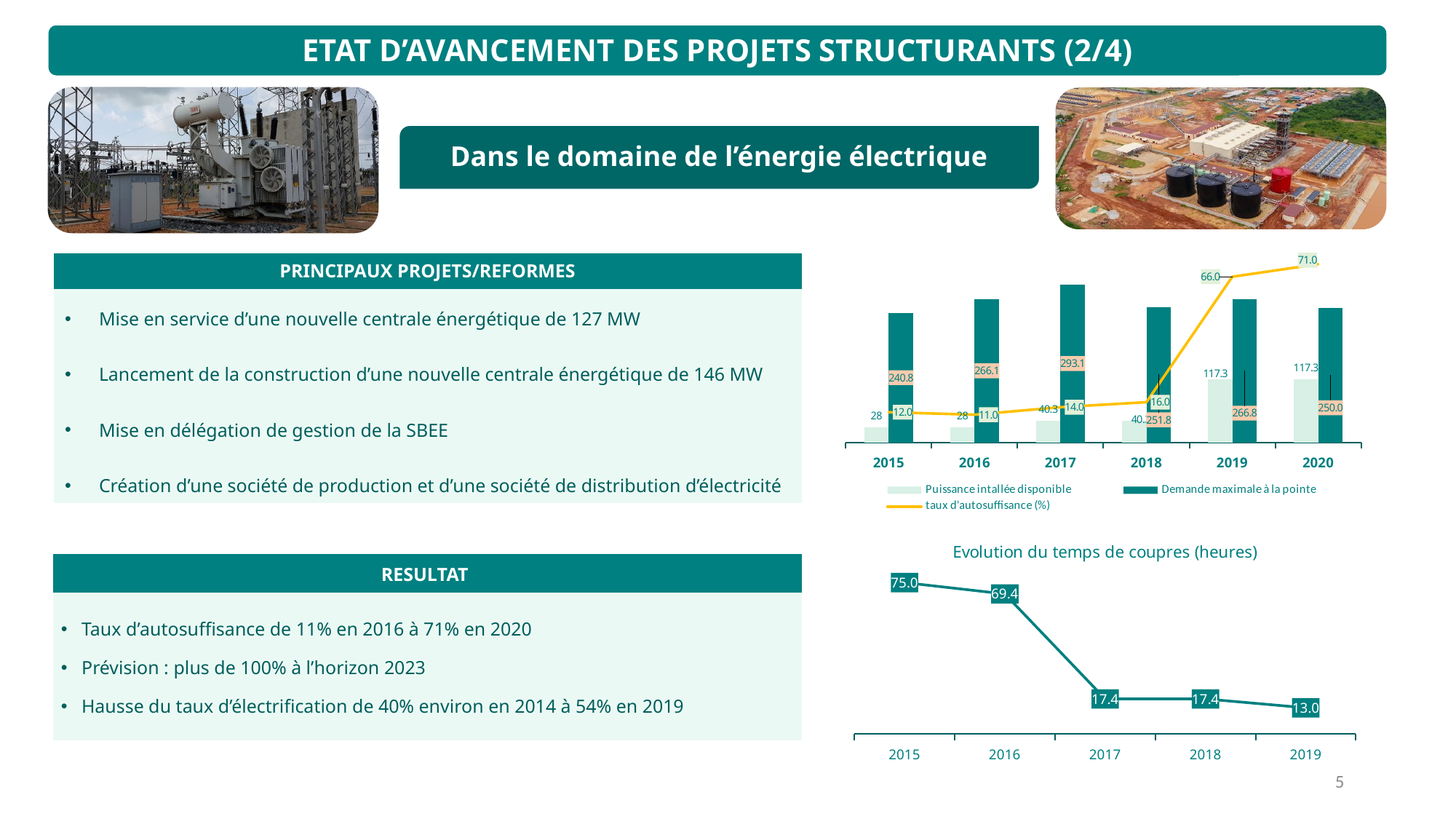
In the bottom-right chart 'Evolution du temps de coupres (heures)', what is the value for 2015? 75.0 In the bottom-right chart 'Evolution du temps de coupres (heures)', what is the difference between the 2015 and 2016 values? 5.6 In the bottom-right chart 'Evolution du temps de coupres (heures)', what kind of chart is it? line chart In the top-right chart, what is the 'Demande maximale à la pointe' value for 2017? 293.1 In the top-right chart, which is larger: the 'Demande maximale à la pointe' for 2016 or for 2020? 2016 In the bottom-right chart 'Evolution du temps de coupres (heures)', what is the value for 2019? 13.0 In the bottom-right chart 'Evolution du temps de coupres (heures)', how many years are plotted? 5 In the top-right chart, which year has the highest 'Demande maximale à la pointe'? 2017 In the bottom-right chart 'Evolution du temps de coupres (heures)', do the values rise or fall from 2015 to 2019? fall In the top-right chart, what is the 'taux d'autosuffisance (%)' value for 2020? 71.0 In the top-right chart, how many series does the legend list? 3 In the bottom-right chart 'Evolution du temps de coupres (heures)', which year has the lowest value? 2019